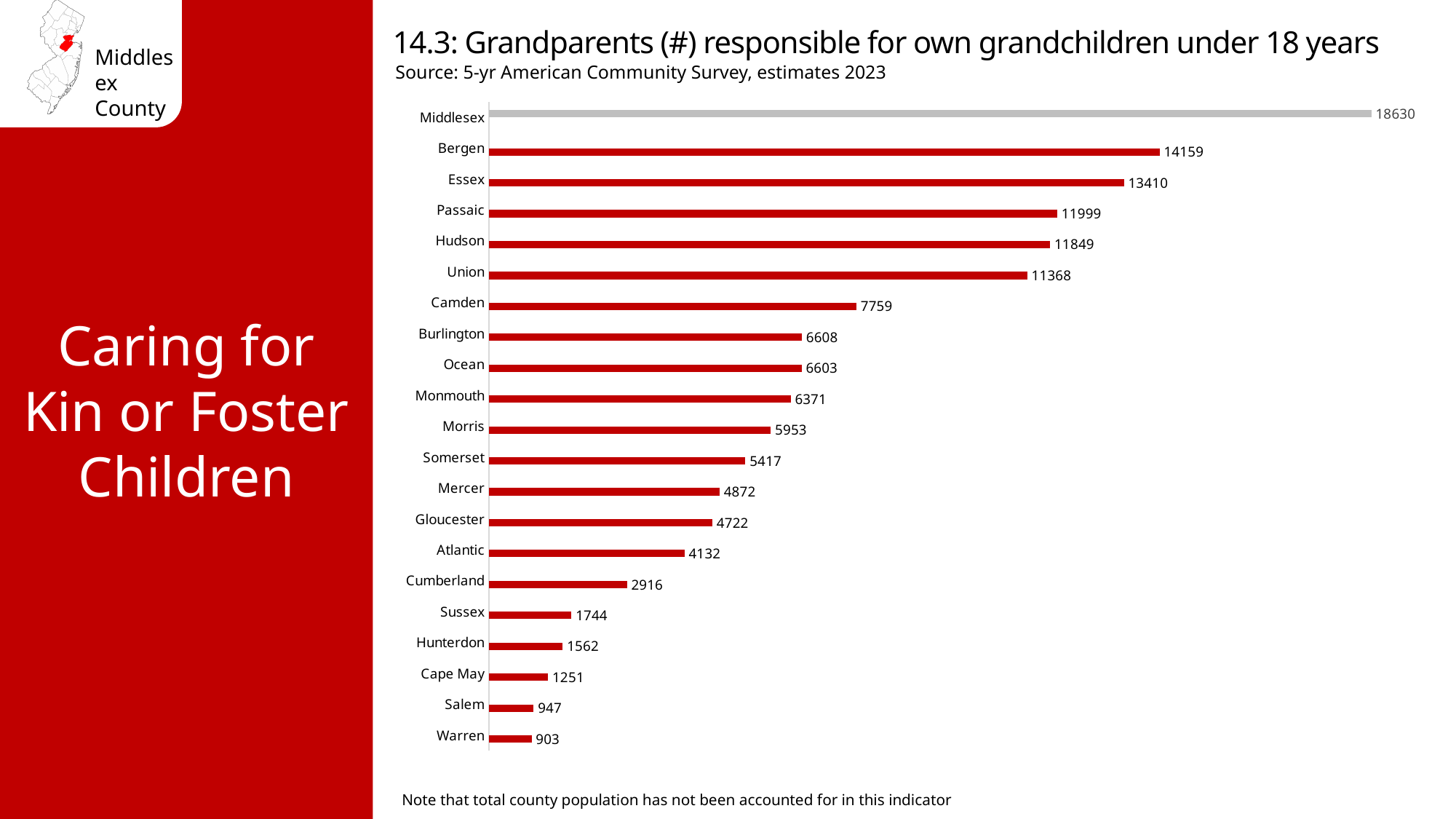
Which county has the lowest value? Warren Which county has the highest value? Middlesex What is the difference between the values for Middlesex and Union? 7262 Which county's bar is shown in grey rather than red? Middlesex What is the value for Middlesex? 18630 What kind of chart is shown on the slide? Bar chart What is the value for Camden? 7759 Which is larger, the value for Passaic or the value for Hudson? Passaic What is the value for Cape May? 1251 What is the difference between the values for Bergen and Essex? 749 Which is larger, the value for Mercer or the value for Atlantic? Mercer How many counties are shown in the chart? 21